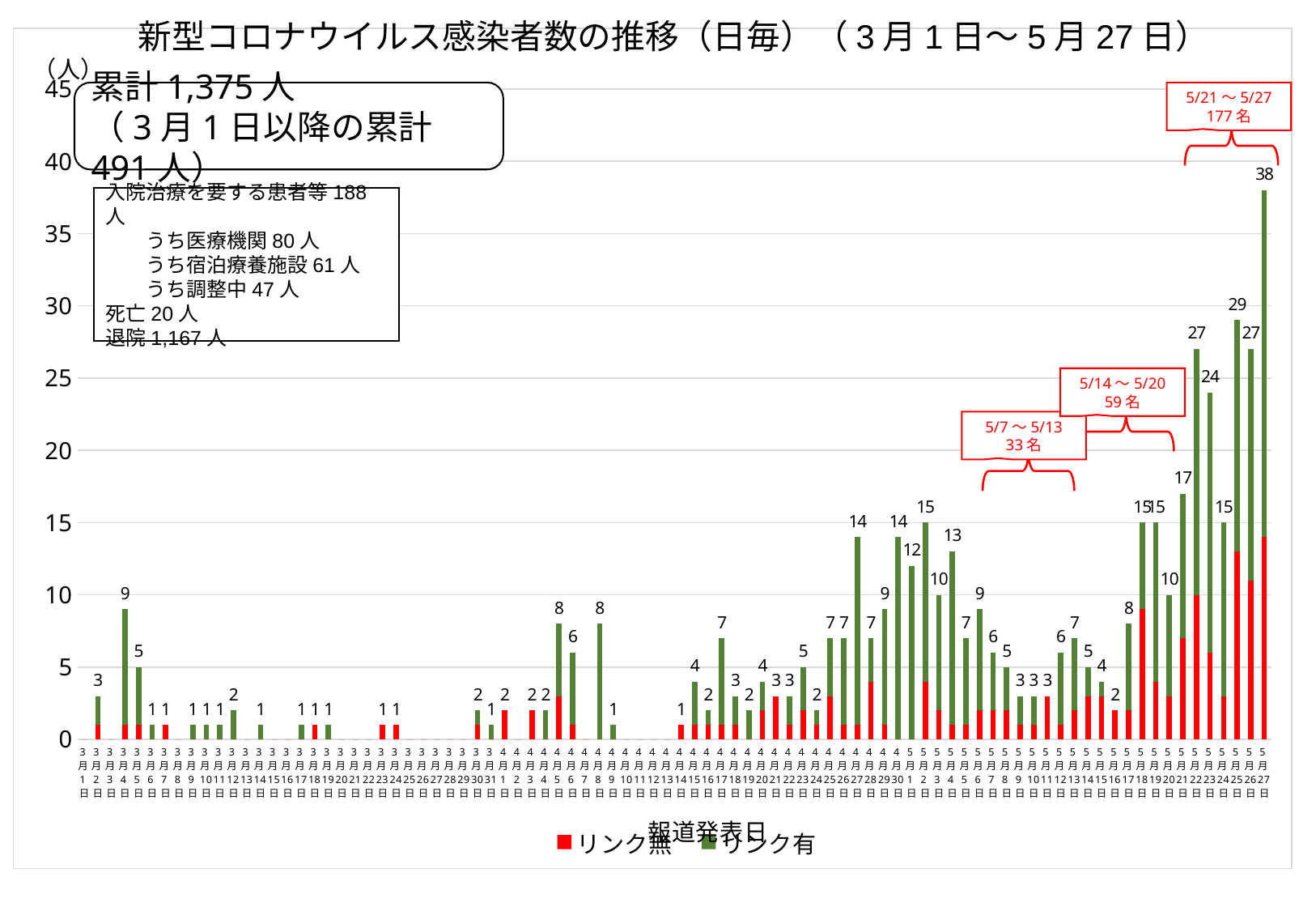
What is the highest daily value shown on the chart, and on which date does it occur? 38 on 5月27日 How many series does the legend list? 2 Which date has the larger total, 5月23日 or 5月21日? 5月23日 What is the total number of cases labelled for 3月4日? 9 Is the リンク無 (red) portion of the bar for 5月27日 greater or less than 10? greater What are the two legend entries of the chart? リンク無 and リンク有 What is the total number of cases labelled for 5月25日? 29 Do the daily totals generally rise or fall from mid-May to 5月27日? Rise What is the difference between the totals for 5月27日 and 5月25日? 9 According to the annotation, how many cases were reported in the period 5/21～5/27? 177名 What is the total number of cases labelled for 5月22日? 27 What kind of chart is shown on the slide? Stacked bar chart